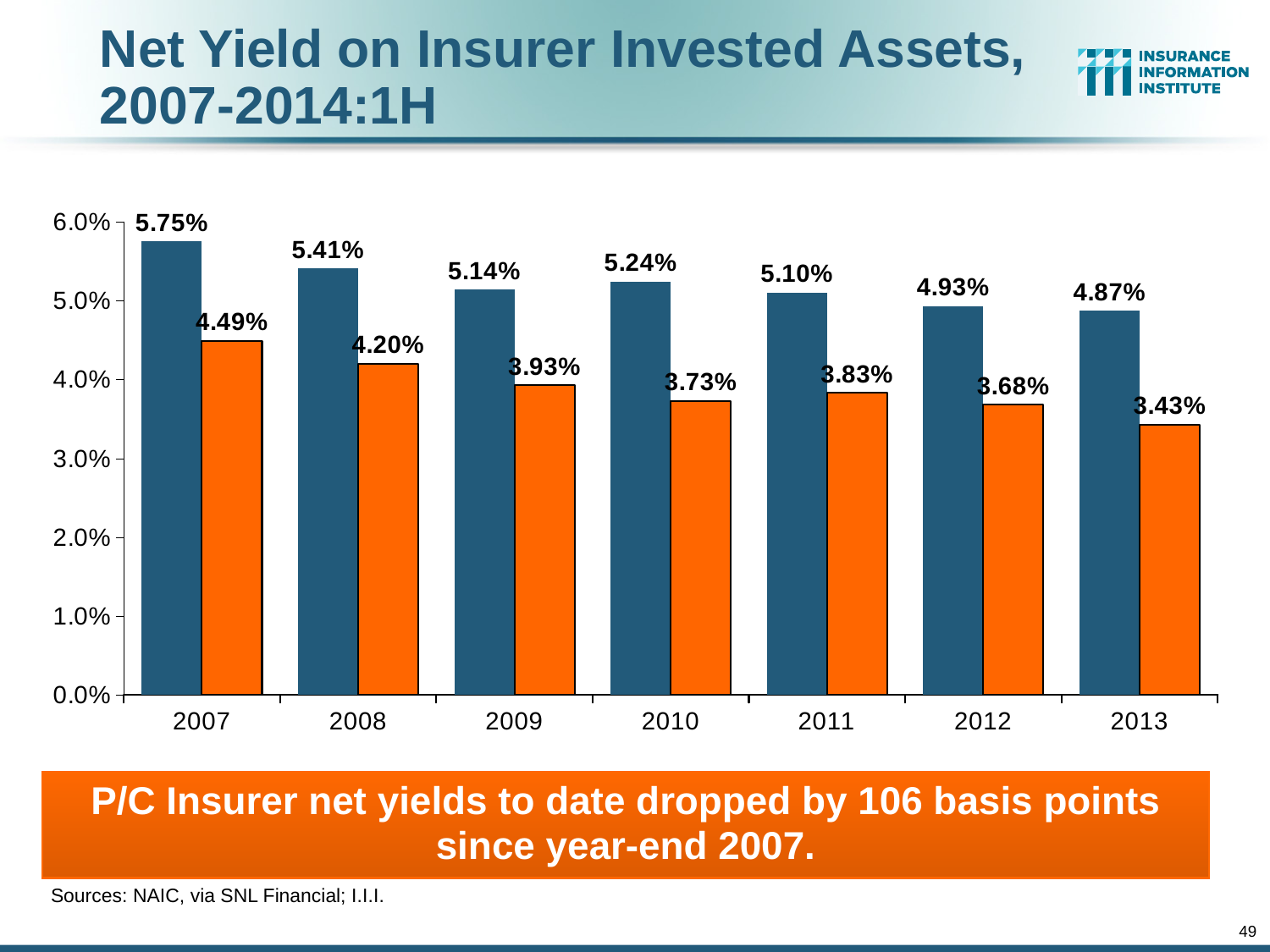
What type of chart is shown on the slide? Bar chart What is the difference between the blue bar and the orange bar for 2011? 1.27% What is the title of the chart on the slide? Net Yield on Insurer Invested Assets, 2007-2014:1H What is the value of the orange bar for 2013? 3.43% Which year has the lowest orange bar? 2013 Which year has the highest blue bar? 2007 What is the value of the blue bar for 2007? 5.75% Is the value of the blue bar for 2013 greater or less than 5.0%? less Do the blue bar values generally rise or fall from 2007 to 2013? Fall Which is larger, the orange bar for 2010 or the orange bar for 2011? 2011 How many years are shown on the x axis of the chart? 7 What is the value of the orange bar for 2010? 3.73%